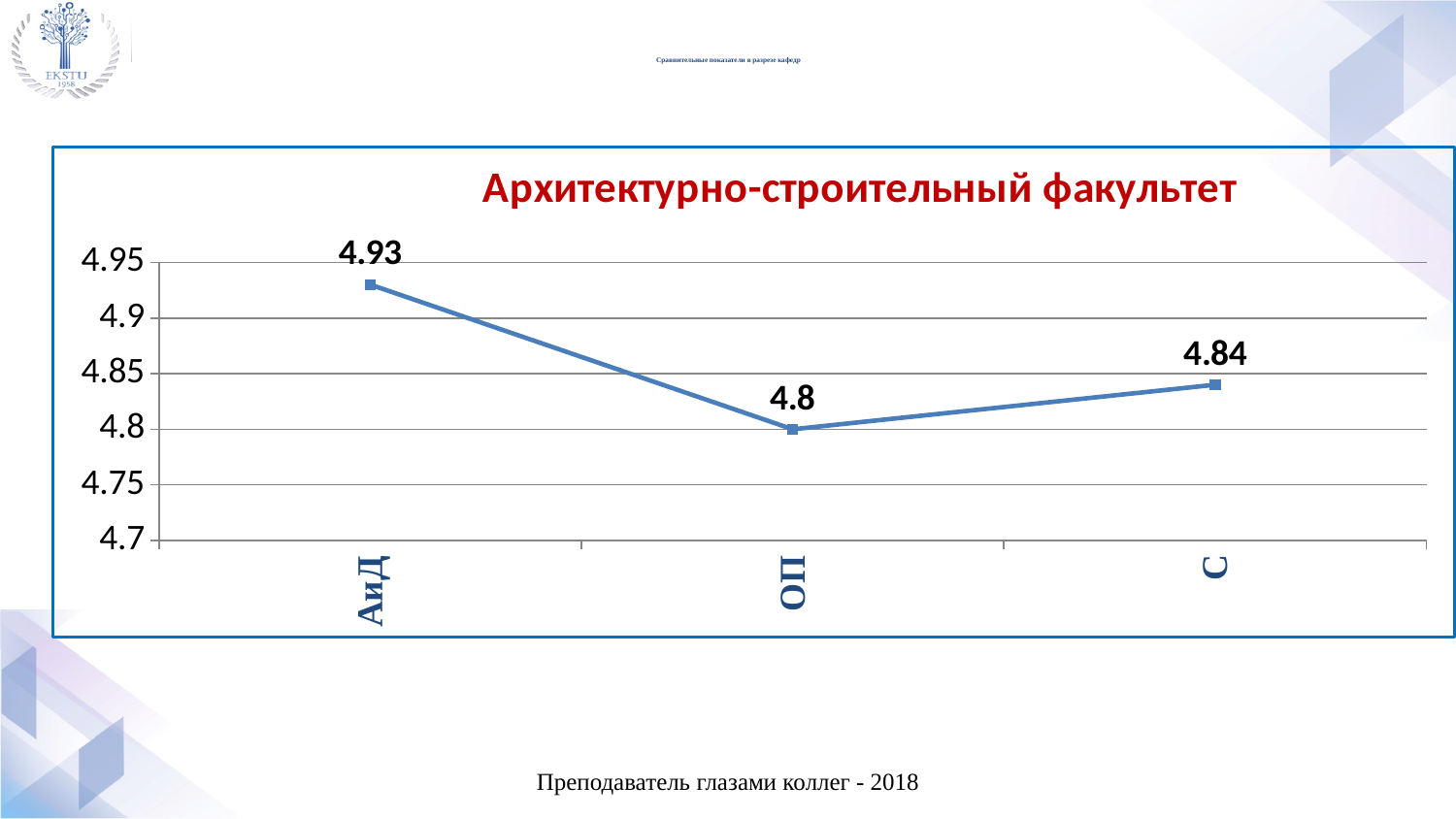
What kind of chart is shown? line chart What is the value for АиД? 4.93 Which category has the lowest value? ОП Which is larger, the value for АиД or the value for С? АиД Is the value for ОП greater or less than 4.85? less Which category has the highest value? АиД What is the difference between the values for С and ОП? 0.04 What is the value for ОП? 4.8 What is the value for С? 4.84 What is the difference between the values for АиД and ОП? 0.13 What is the title of the chart? Архитектурно-строительный факультет How many categories are plotted on the x axis? 3